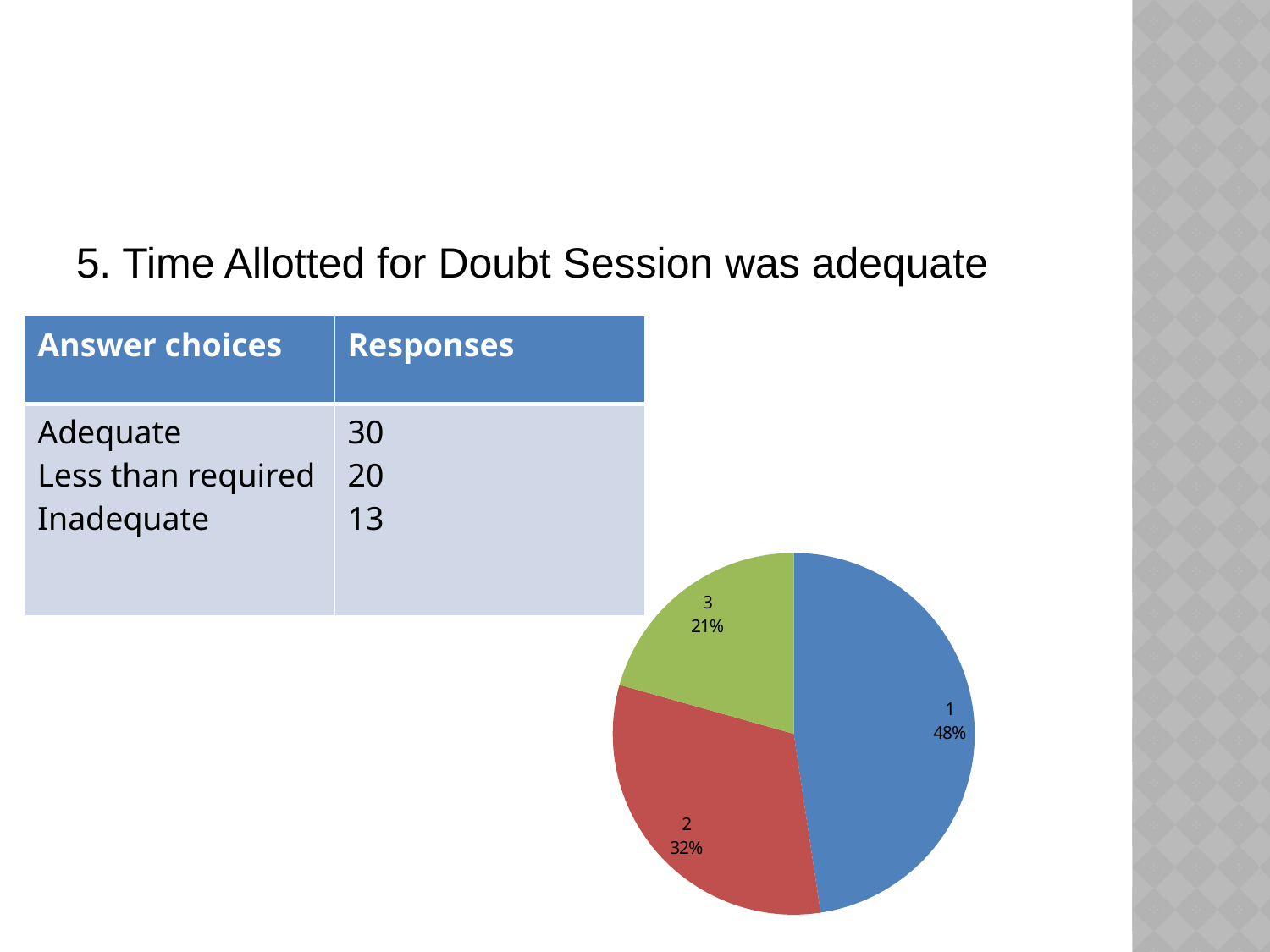
What share of the pie chart does slice 3 represent? 21% What share of the pie chart does slice 2 represent? 32% Which slice of the pie chart is the largest? 1 What is the difference in percentage points between slice 1 and slice 2 in the pie chart? 16% What kind of chart is shown on the slide? Pie chart Which slice is larger in the pie chart, slice 2 or slice 3? 2 What colour is slice 3 in the pie chart? Green What share of the pie chart does slice 1 represent? 48% How many slices does the pie chart have? 3 Which slice of the pie chart is the smallest? 3 What is the difference in percentage points between slice 2 and slice 3 in the pie chart? 11% What colour is slice 1 in the pie chart? Blue